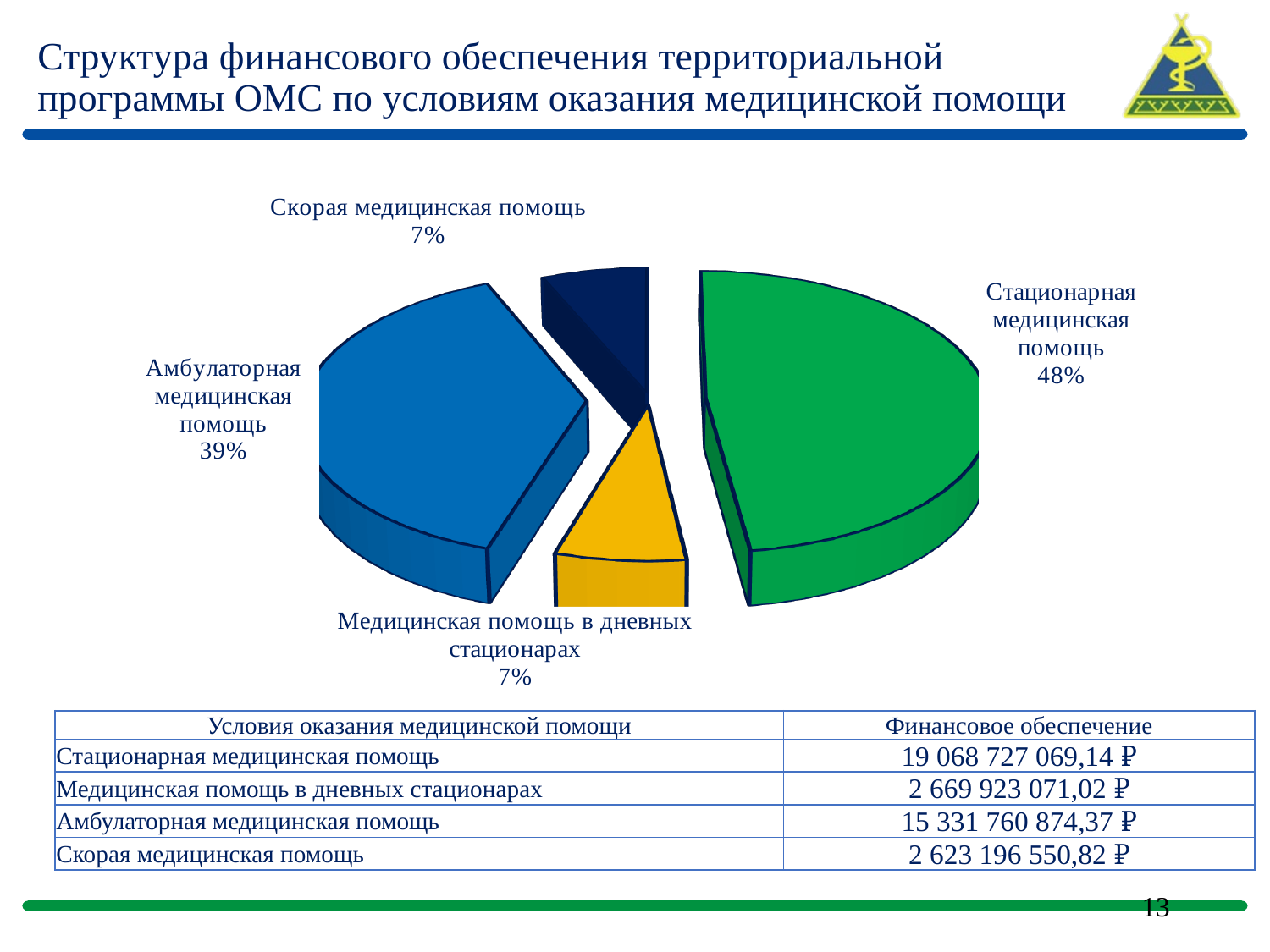
What share of the pie does Стационарная медицинская помощь have? 48% What share of the pie does Скорая медицинская помощь have? 7% According to the table below the chart, what is the financial provision for Скорая медицинская помощь? 2 623 196 550,82 ₽ Which category has the largest slice of the pie? Стационарная медицинская помощь Which is larger: the share for Стационарная медицинская помощь or for Амбулаторная медицинская помощь? Стационарная медицинская помощь What share of the pie does Медицинская помощь в дневных стационарах have? 7% How many slices does the pie chart have? 4 What colour is the slice for Стационарная медицинская помощь? green What kind of chart is shown on the slide? pie chart What colour is the slice for Медицинская помощь в дневных стационарах? yellow By how many percentage points does the share of Стационарная медицинская помощь exceed that of Амбулаторная медицинская помощь? 9